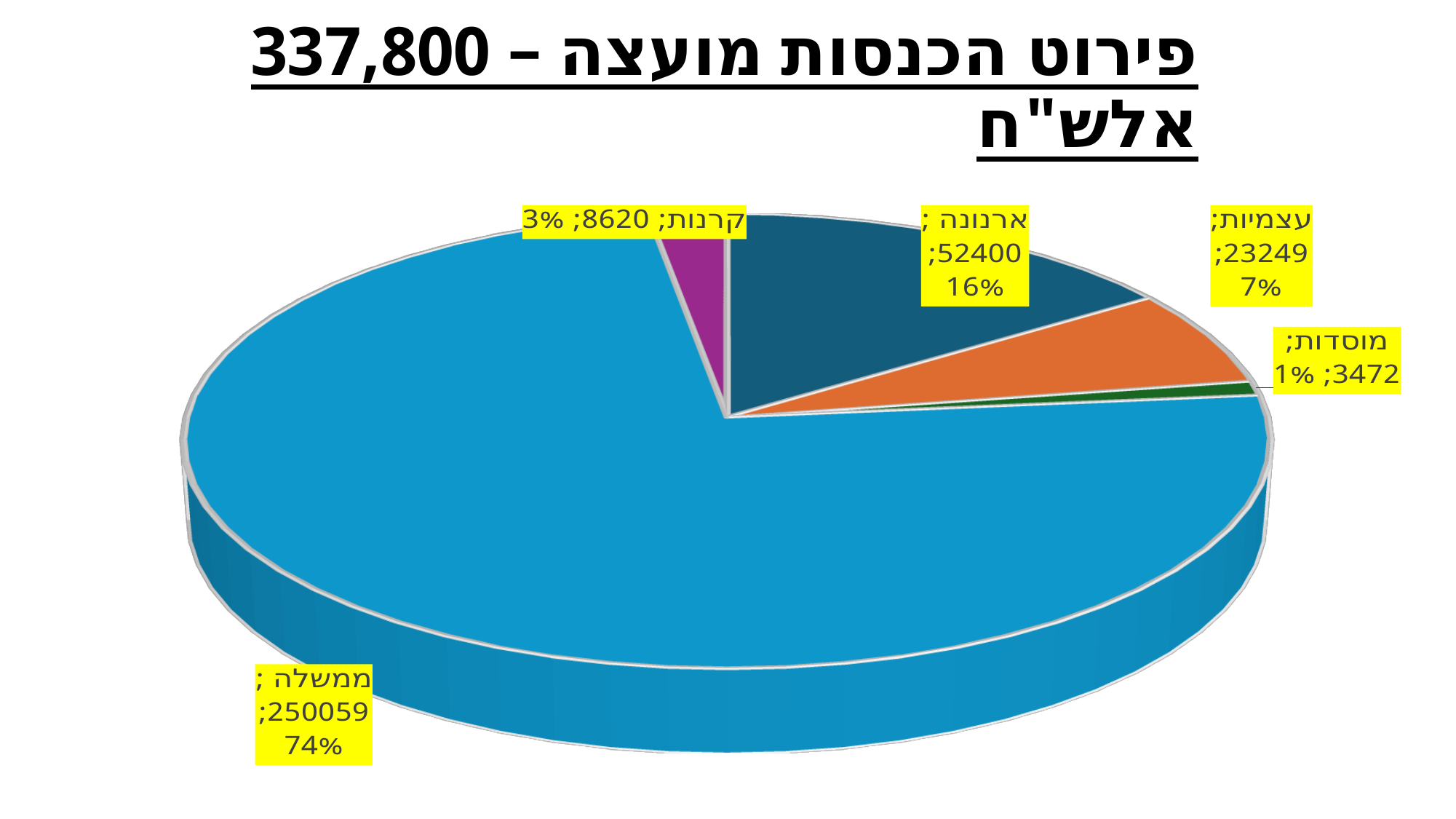
What is the difference between the values for ארנונה and קרנות? 43780 Which is larger, the value for ארנונה or the value for עצמיות? ארנונה What is the value shown for ארנונה? 52400 What kind of chart is shown on the slide? pie chart Which category has the largest slice of the pie? ממשלה Which category has the smallest slice of the pie? מוסדות How many slices does the pie chart have? 5 What is the value shown for קרנות? 8620 What percentage share of the pie does מוסדות have? 1% What is the value shown for ממשלה? 250059 What is the value shown for עצמיות? 23249 What percentage share of the pie does ממשלה have? 74%